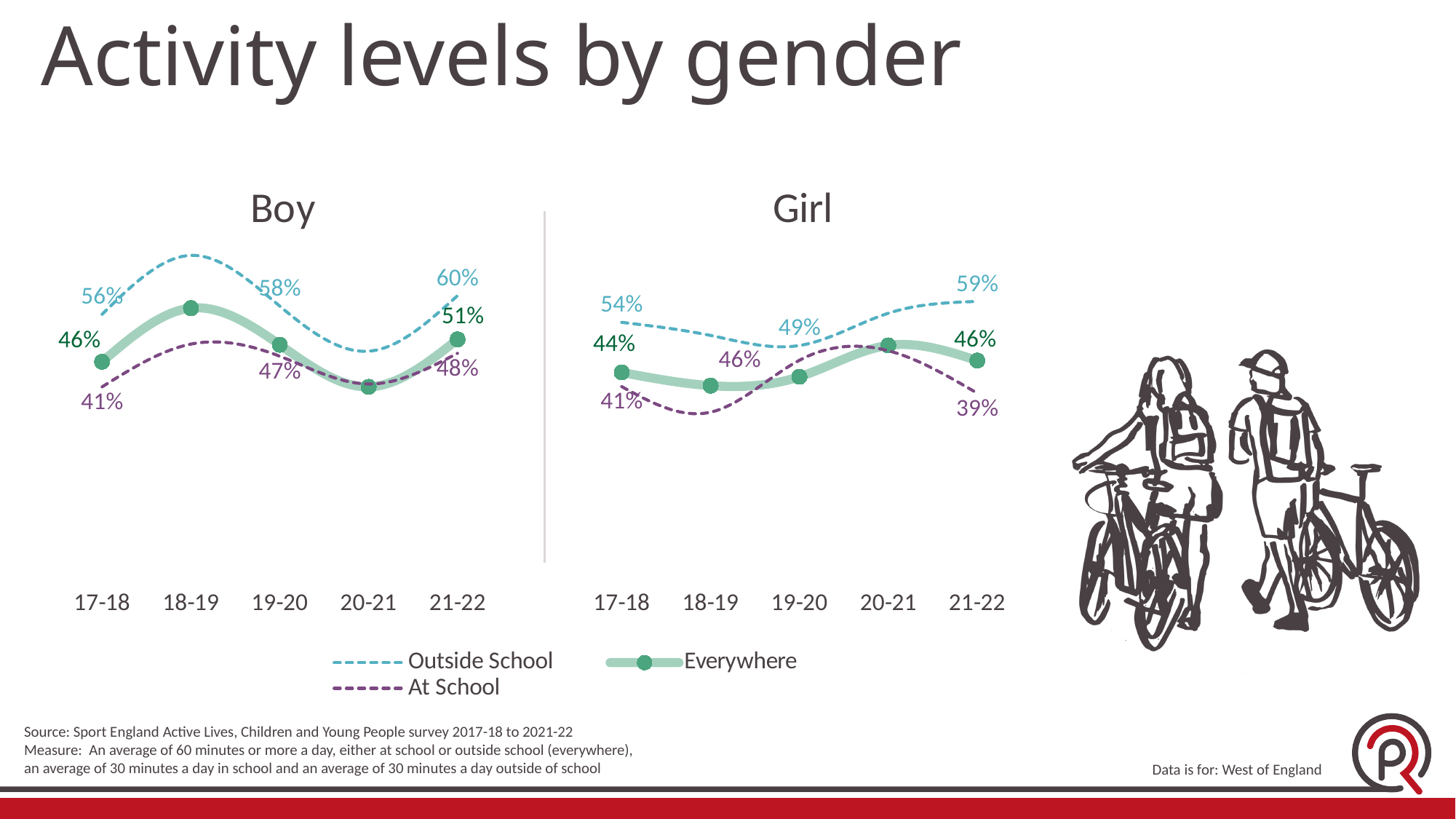
On the Boy chart, what is the At School value for 17-18? 41% On the Boy chart, what is the difference between the Outside School and At School values for 21-22? 12 percentage points How many series does the legend list? 3 What kind of chart is used for the Boy and Girl panels? line chart On the Girl chart, does the At School value rise or fall from 19-20 to 21-22? fall On the Boy chart, what is the Everywhere value for 17-18? 46% Which chart shows the higher Everywhere value for 21-22, Boy or Girl? Boy On the Girl chart, what is the Outside School value for 19-20? 49% On the Girl chart, what is the At School value for 21-22? 39% How many time periods are shown on the x axis of the Boy chart? 5 On the Boy chart, what is the Outside School value for 21-22? 60% On the Girl chart, by how much did the Everywhere value change from 17-18 to 21-22? 2 percentage points